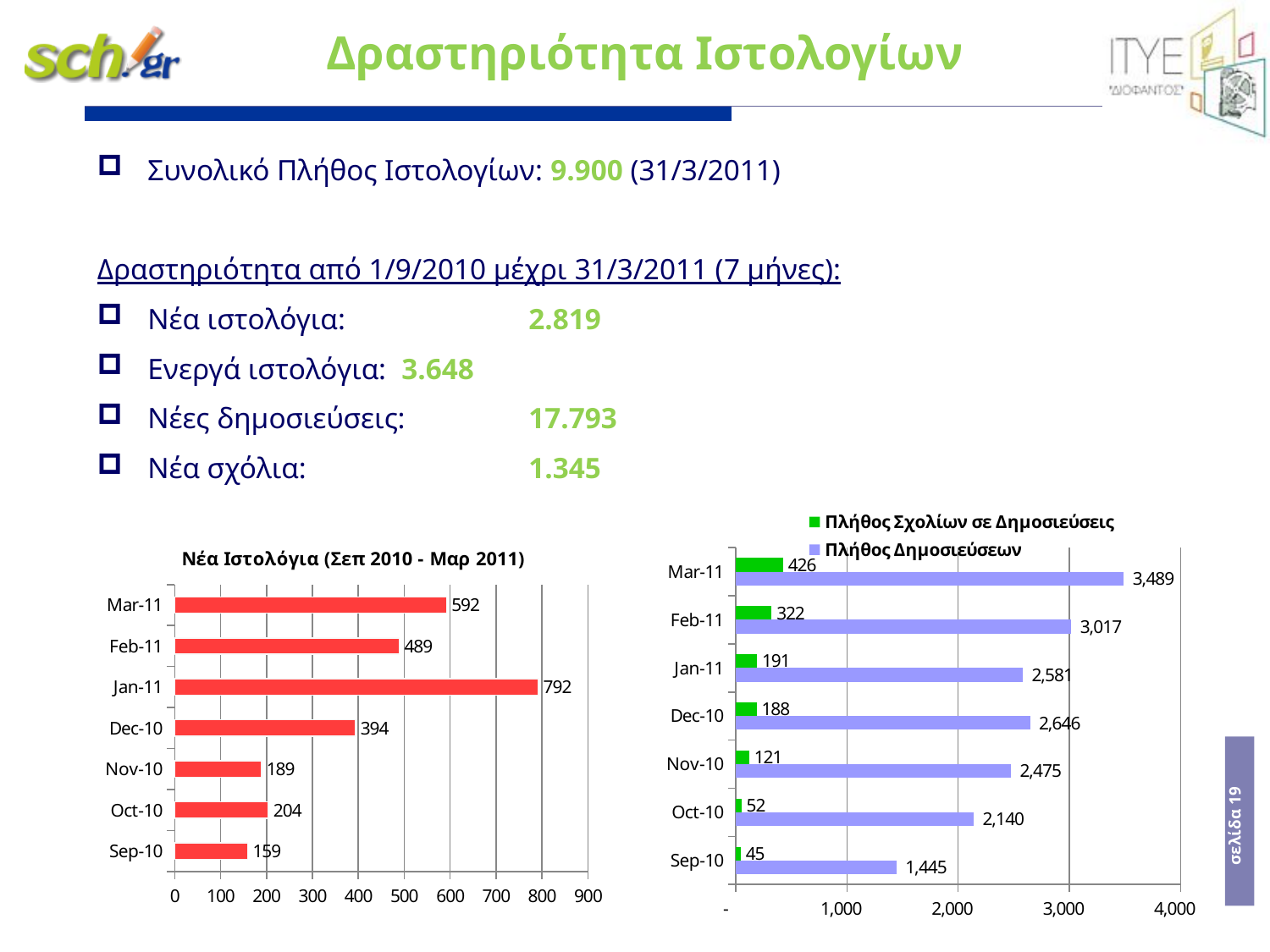
In the chart titled 'Νέα Ιστολόγια (Σεπ 2010 - Μαρ 2011)', which month has the highest value? Jan-11 In the chart titled 'Νέα Ιστολόγια (Σεπ 2010 - Μαρ 2011)', how many months are shown? 7 In the chart on the right of the slide, what is the value of 'Πλήθος Σχολίων σε Δημοσιεύσεις' for Oct-10? 52 In the chart on the right of the slide, what is the value of 'Πλήθος Δημοσιεύσεων' for Mar-11? 3,489 In the chart on the right of the slide, what is the difference between 'Πλήθος Σχολίων σε Δημοσιεύσεις' for Mar-11 and Feb-11? 104 In the chart titled 'Νέα Ιστολόγια (Σεπ 2010 - Μαρ 2011)', what is the difference between the values for Mar-11 and Feb-11? 103 In the chart on the right of the slide, which month has the lowest value of 'Πλήθος Δημοσιεύσεων'? Sep-10 In the chart on the right of the slide, is the value of 'Πλήθος Δημοσιεύσεων' for Dec-10 larger or smaller than for Jan-11? Larger In the chart on the right of the slide, how many series does the legend list? 2 In the chart titled 'Νέα Ιστολόγια (Σεπ 2010 - Μαρ 2011)', what is the value for Jan-11? 792 In the chart titled 'Νέα Ιστολόγια (Σεπ 2010 - Μαρ 2011)', which month has the lowest value? Sep-10 What kind of chart is the chart titled 'Νέα Ιστολόγια (Σεπ 2010 - Μαρ 2011)'? Bar chart